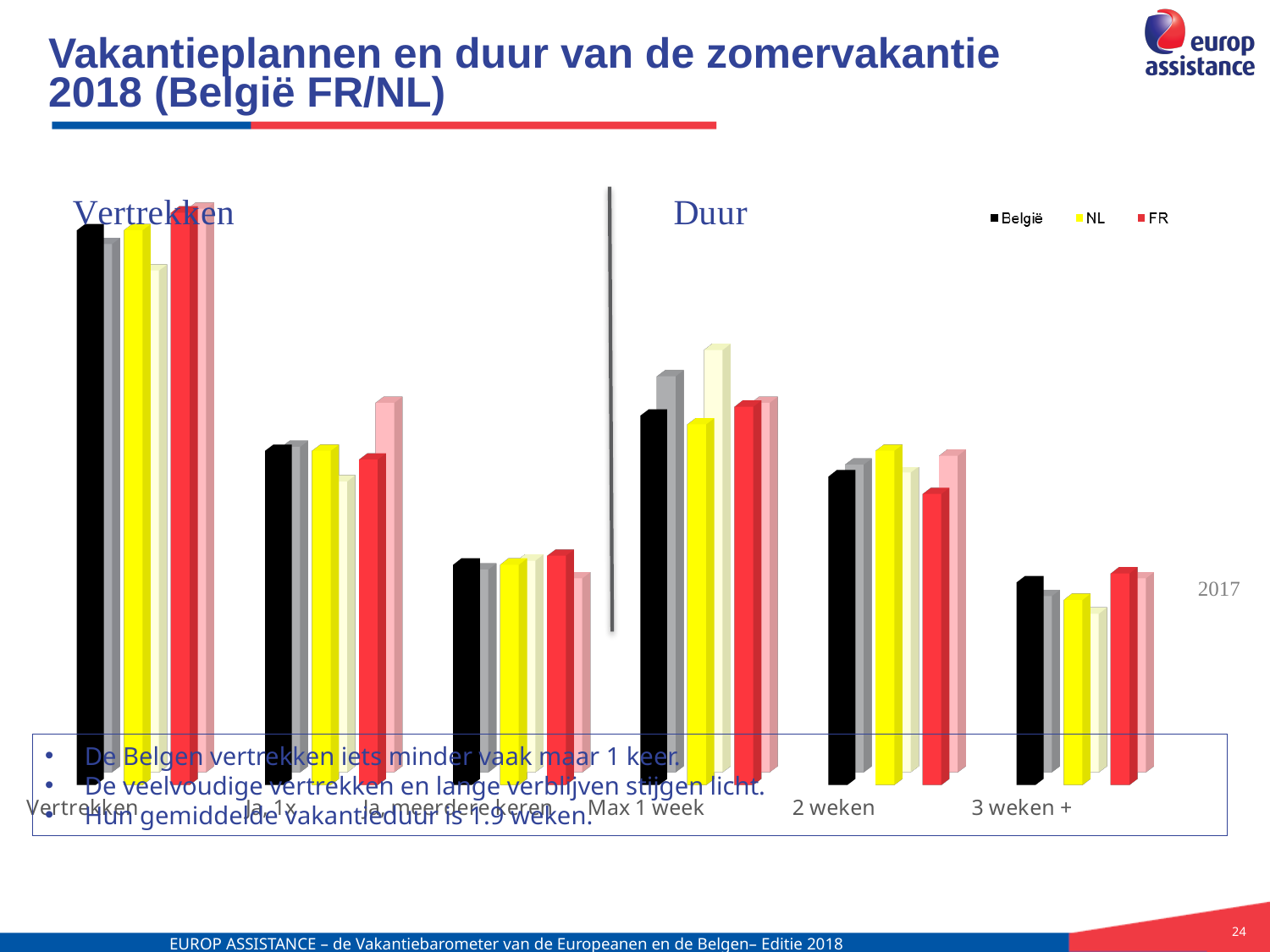
Which category has the shortest bar for België? 3 weken + For the category '2 weken', which is larger: NL or FR? NL How many series does the legend list? 3 What kind of chart is shown on the slide? Bar chart How many categories are shown along the x axis? 6 Which category has the shortest bar for NL? 3 weken + For the category '3 weken +', which is larger: FR or NL? FR What is the title of the slide containing the chart? Vakantieplannen en duur van de zomervakantie 2018 (België FR/NL) For FR, which is larger: 'Ja, 1x' or 'Ja, meerdere keren'? Ja, 1x Going from 'Max 1 week' to '2 weken' to '3 weken +', do the België values rise or fall? Fall Which series are listed in the legend? België, NL, FR Which category has the tallest bar for België? Vertrekken